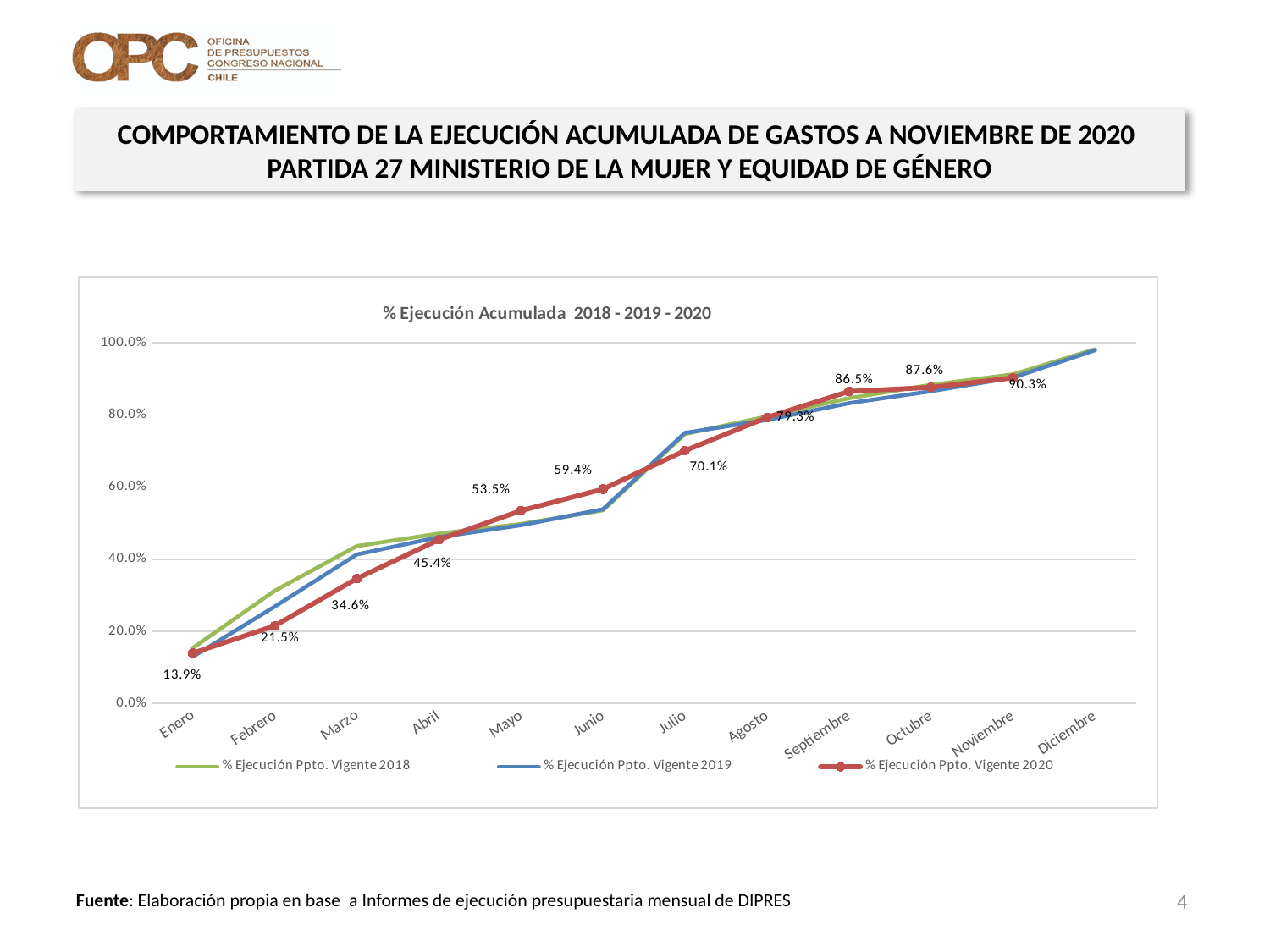
What kind of chart is shown on the slide? Line chart Which month has the highest value in the % Ejecución Ppto. Vigente 2020 series? Noviembre What is the difference between the Septiembre and Agosto values in the % Ejecución Ppto. Vigente 2020 series? 7.2 percentage points What is the value for Abril in the % Ejecución Ppto. Vigente 2020 series? 45.4% What is the value for Enero in the % Ejecución Ppto. Vigente 2020 series? 13.9% Is the value for Julio in the % Ejecución Ppto. Vigente 2019 series greater or less than 60.0%? greater What is the value for Noviembre in the % Ejecución Ppto. Vigente 2020 series? 90.3% Which month has the lowest value in the % Ejecución Ppto. Vigente 2020 series? Enero In Marzo, which series has the larger value: % Ejecución Ppto. Vigente 2018 or % Ejecución Ppto. Vigente 2020? % Ejecución Ppto. Vigente 2018 What is the value for Julio in the % Ejecución Ppto. Vigente 2020 series? 70.1% What is the difference between the Noviembre and Enero values in the % Ejecución Ppto. Vigente 2020 series? 76.4 percentage points How many series does the legend list? 3